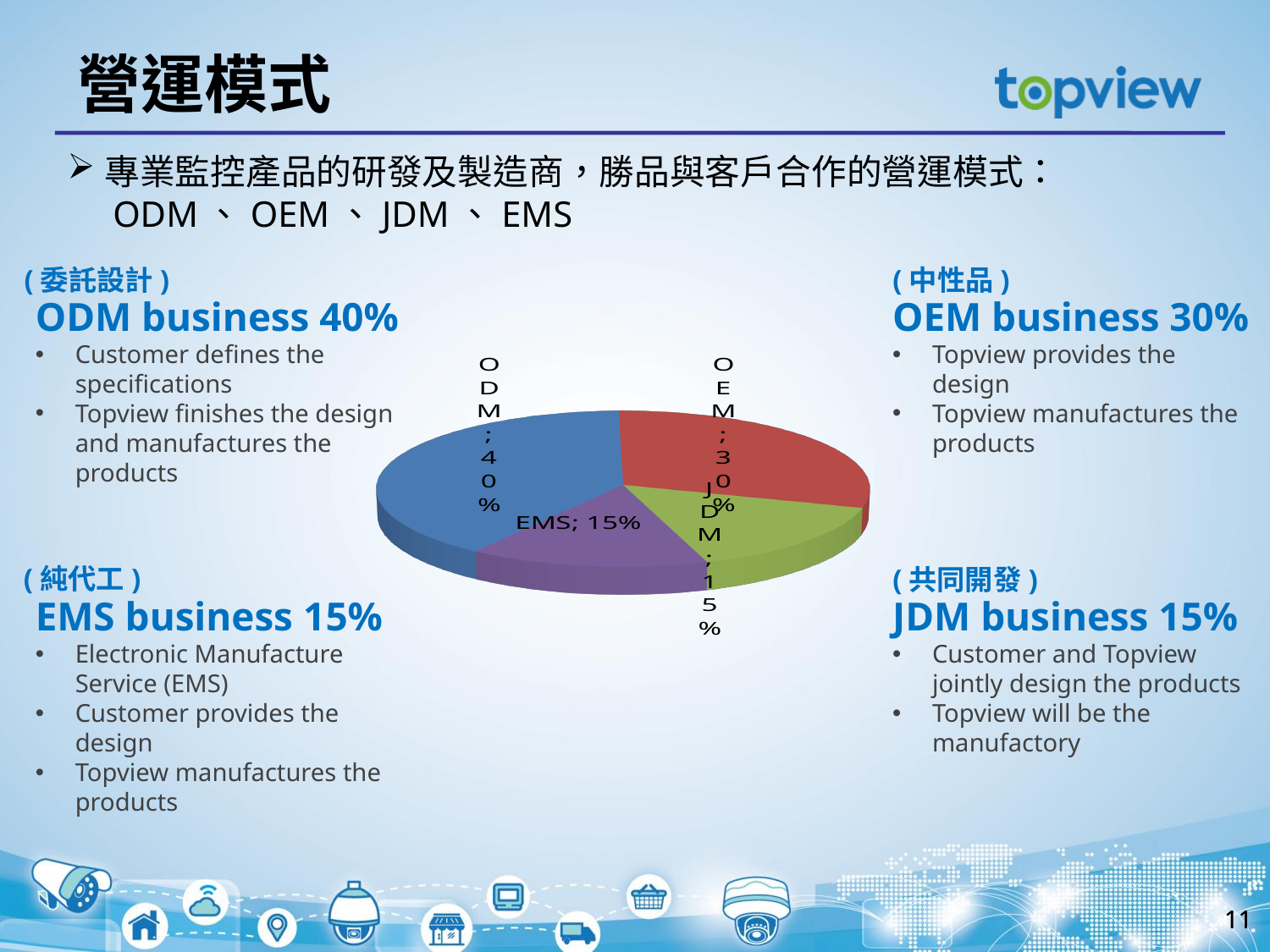
What is the difference in percentage points between the OEM slice and the JDM slice? 15% What kind of chart is shown on the slide? pie chart What share of the pie does OEM have? 30% What share of the pie does JDM have? 15% What colour is the ODM slice in the pie chart? blue How many slices does the pie chart have? 4 What share of the pie does ODM have? 40% What is the difference in percentage points between the ODM slice and the OEM slice? 10% What share of the pie does EMS have? 15% Which is larger in the pie chart, ODM or OEM? ODM Which business model has the largest slice of the pie? ODM What is the combined share of the JDM and EMS slices? 30%